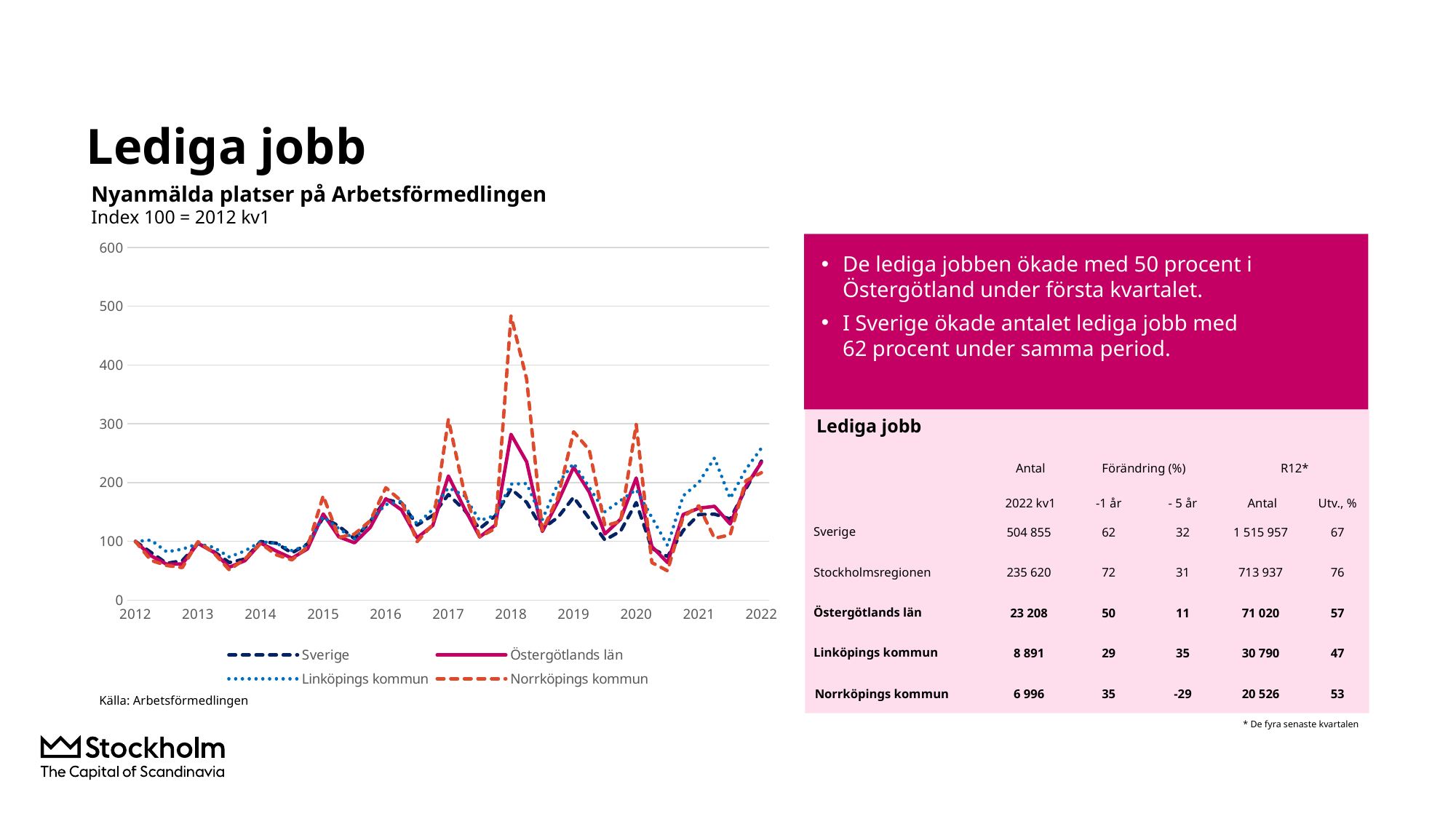
Is the value for Linköpings kommun at the end of the series in 2022 greater or less than 200? greater What is the title of the chart? Nyanmälda platser på Arbetsförmedlingen What is the index value of the series at 2012 kv1, the base period? 100 Is the lowest value for Sverige around 2020 greater or less than 100? less Do the index values generally rise or fall from 2012 to 2022? Rise What kind of chart is shown on the slide? Line chart How many series does the chart legend list? 4 Which series has the highest value at the end of the chart in 2022? Linköpings kommun Which series reaches the highest peak in the chart? Norrköpings kommun Is the peak value for Östergötlands län in 2018 greater or less than 300? less Which series are listed in the chart legend? Sverige, Östergötlands län, Linköpings kommun, Norrköpings kommun